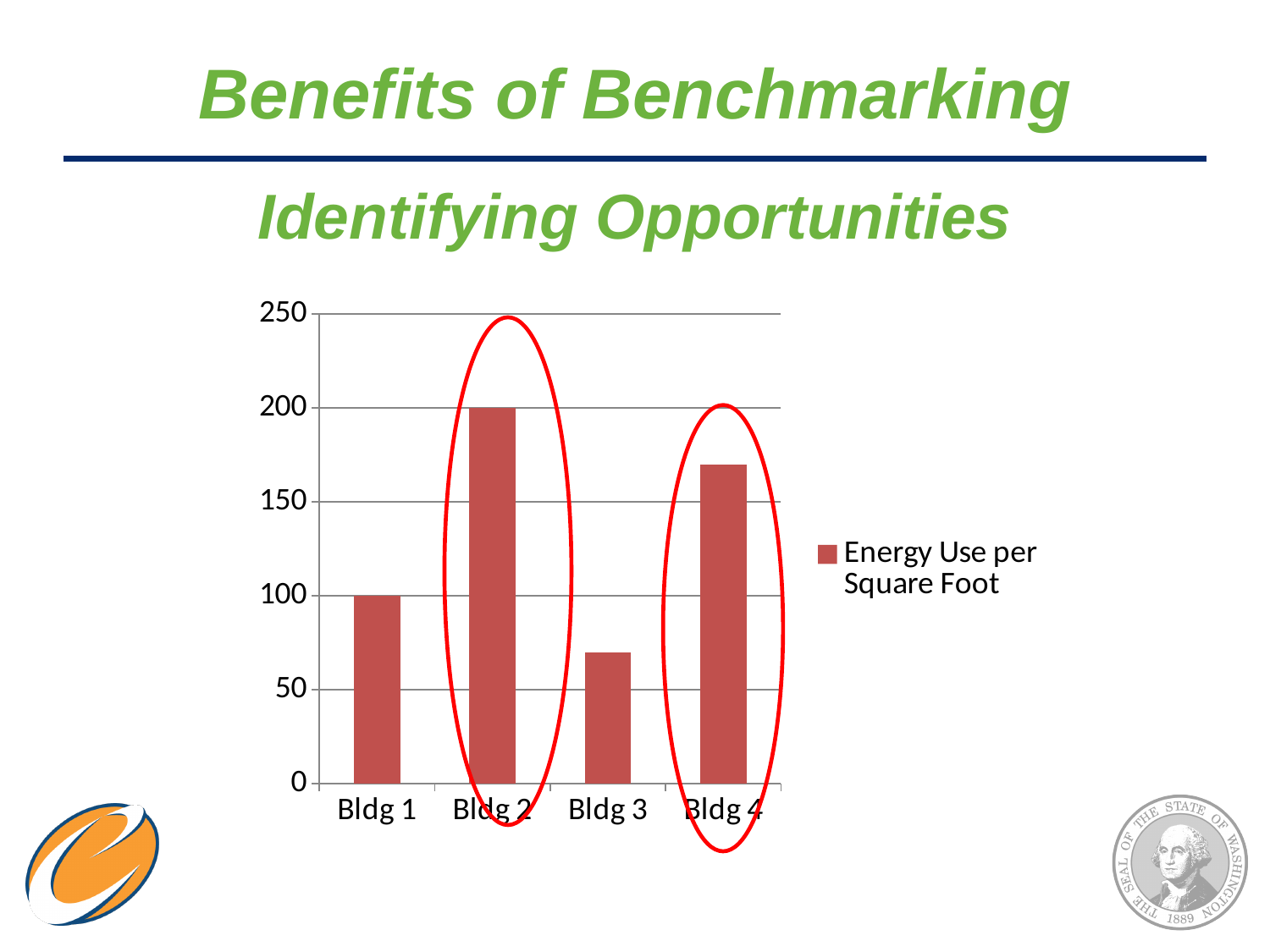
How many buildings are shown on the x axis? 4 Which is larger, the value for Bldg 4 or the value for Bldg 1? Bldg 4 Is the value for Bldg 4 greater or less than 150? greater What is the value for Bldg 2? 200 How many series does the legend list? 1 Which building has the highest energy use per square foot? Bldg 2 What is the value for Bldg 1? 100 Is the value for Bldg 3 greater or less than 100? less What is the difference between the values for Bldg 2 and Bldg 1? 100 What kind of chart is shown on the slide? bar chart Which buildings are circled in red on the chart? Bldg 2 and Bldg 4 Which building has the lowest energy use per square foot? Bldg 3